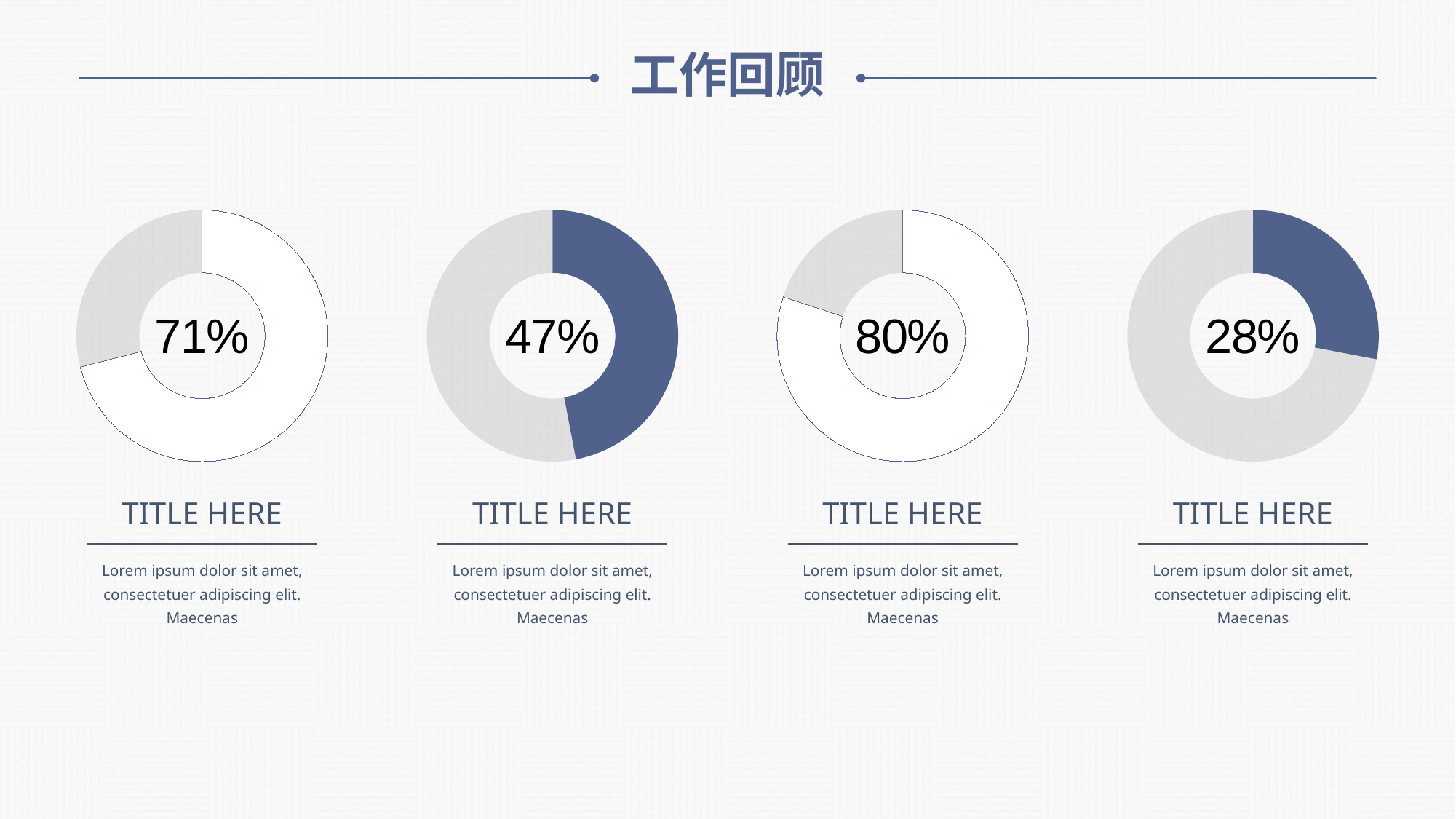
What is the title of the slide? 工作回顾 Which is larger, the percentage in the leftmost donut chart or the percentage in the second donut chart? The leftmost (71%) What percentage is shown in the centre of the second donut chart from the left? 47% What is the difference between the percentage in the leftmost donut chart and the percentage in the second donut chart? 24% What percentage is shown in the centre of the leftmost donut chart? 71% How many donut charts are on the slide? 4 Which of the four donut charts shows the highest percentage? The third from the left (80%) What kind of chart is used for each of the four figures on the slide? Donut chart Which of the four donut charts shows the lowest percentage? The rightmost (28%) What percentage is shown in the centre of the rightmost donut chart? 28% What percentage is shown in the centre of the third donut chart from the left? 80% What is the difference between the percentage in the third donut chart and the percentage in the rightmost donut chart? 52%